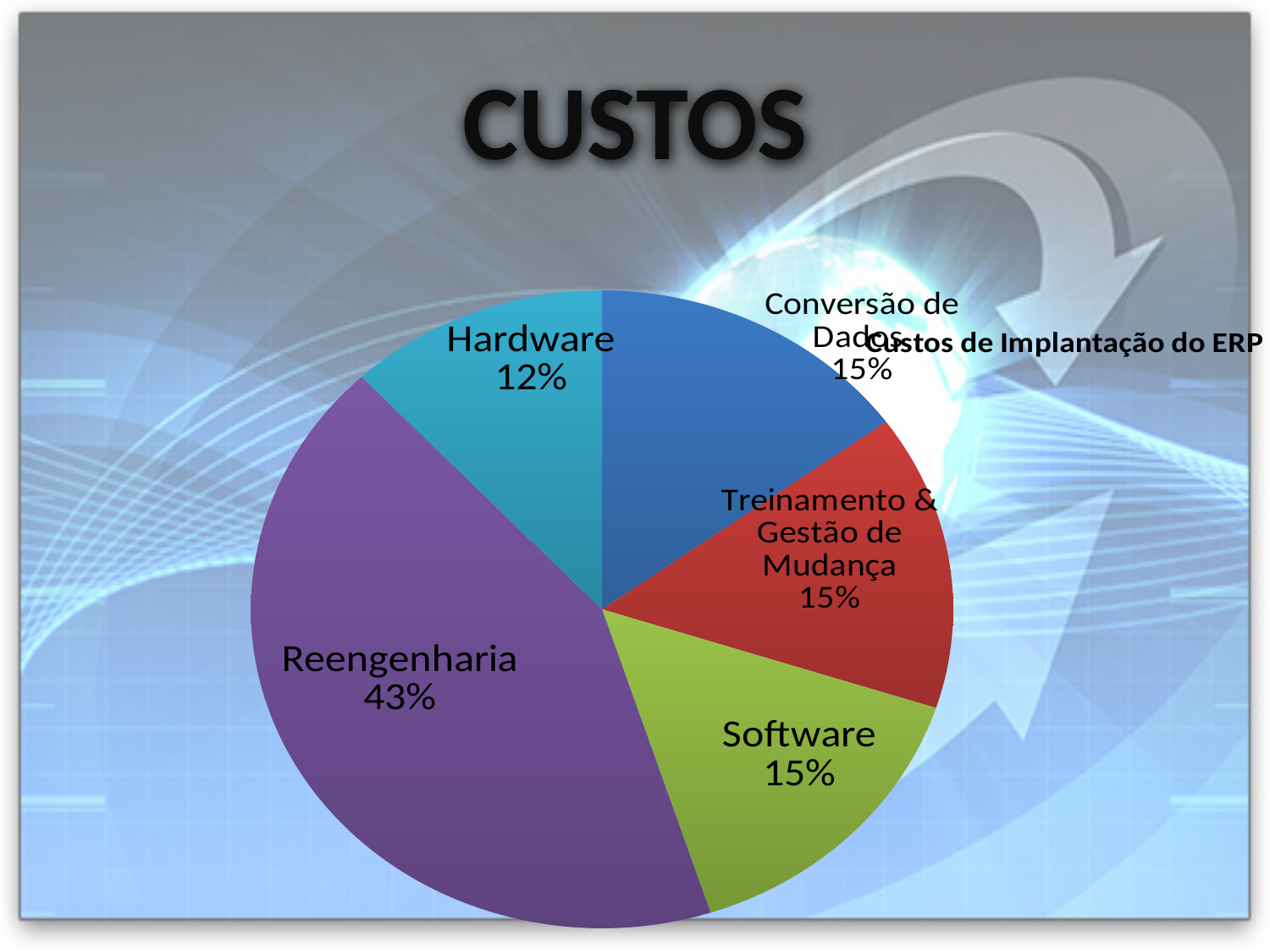
What share of the pie does Reengenharia represent? 43% What is the value shown for Conversão de Dados? 15% What share of the pie does Hardware represent? 12% Which category has the smallest slice of the pie? Hardware Which category has the largest slice of the pie? Reengenharia Which is larger, the slice for Reengenharia or the slice for Software? Reengenharia What is the value shown for Treinamento & Gestão de Mudança? 15% What kind of chart is shown on the slide? Pie chart What is the value shown for Software? 15% What is the title of the pie chart? Custos de Implantação do ERP What is the difference in percentage points between Reengenharia and Hardware? 31 How many slices does the pie chart have? 5